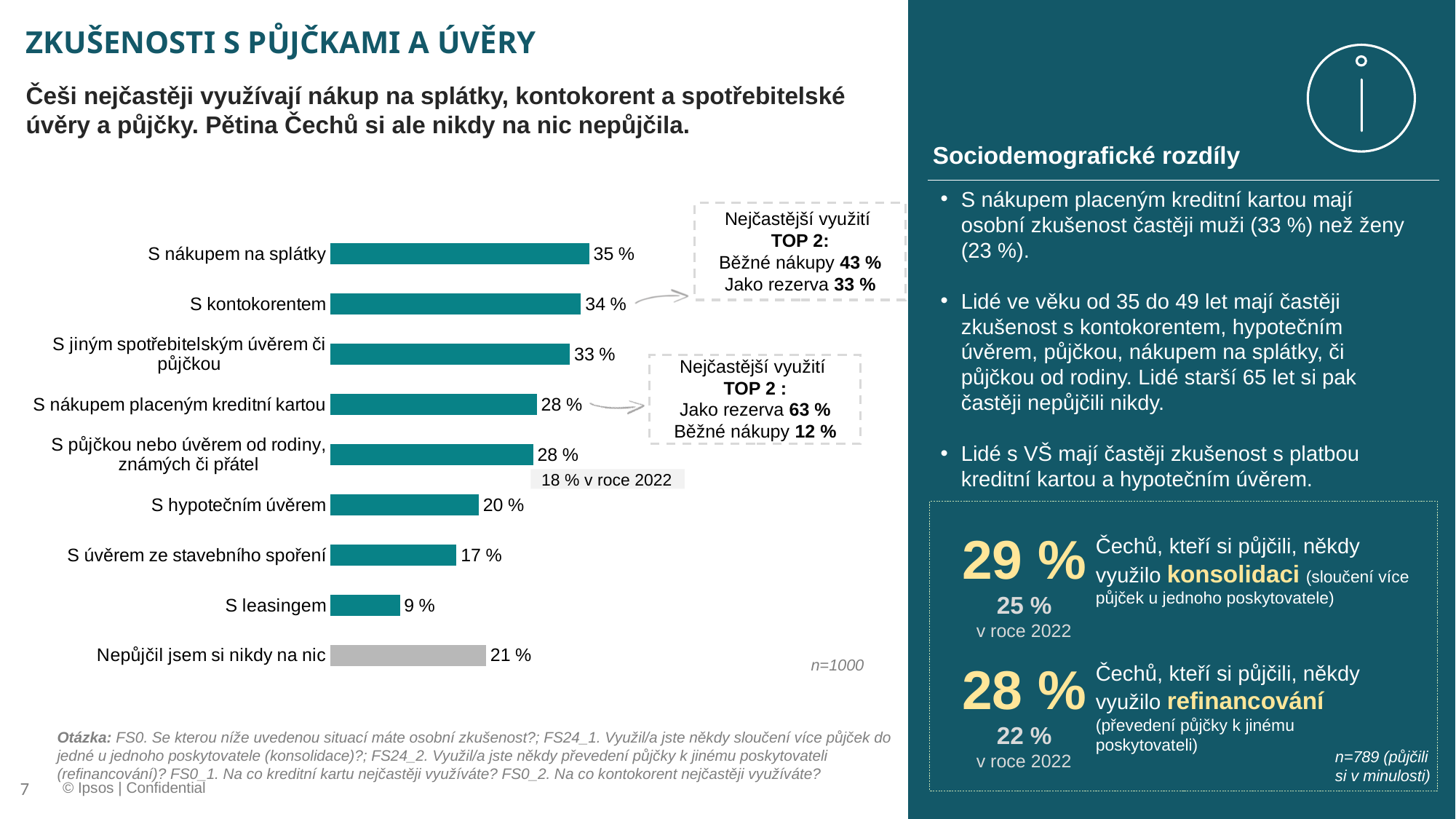
What is the value for "S hypotečním úvěrem"? 20 % Which category has the highest value? S nákupem na splátky What was the value for "S půjčkou nebo úvěrem od rodiny, známých či přátel" in 2022, according to the note under the bar? 18 % What is the value for "Nepůjčil jsem si nikdy na nic"? 21 % Which is larger: the value for "S hypotečním úvěrem" or the value for "Nepůjčil jsem si nikdy na nic"? Nepůjčil jsem si nikdy na nic What sample size (n) is shown next to the chart? n=1000 How many categories are shown in the chart? 9 What is the value for "S nákupem na splátky"? 35 % Which category has the lowest value? S leasingem What is the difference between the values for "S kontokorentem" and "S úvěrem ze stavebního spoření"? 17 % What kind of chart is shown on the slide? bar chart What is the value for "S leasingem"? 9 %